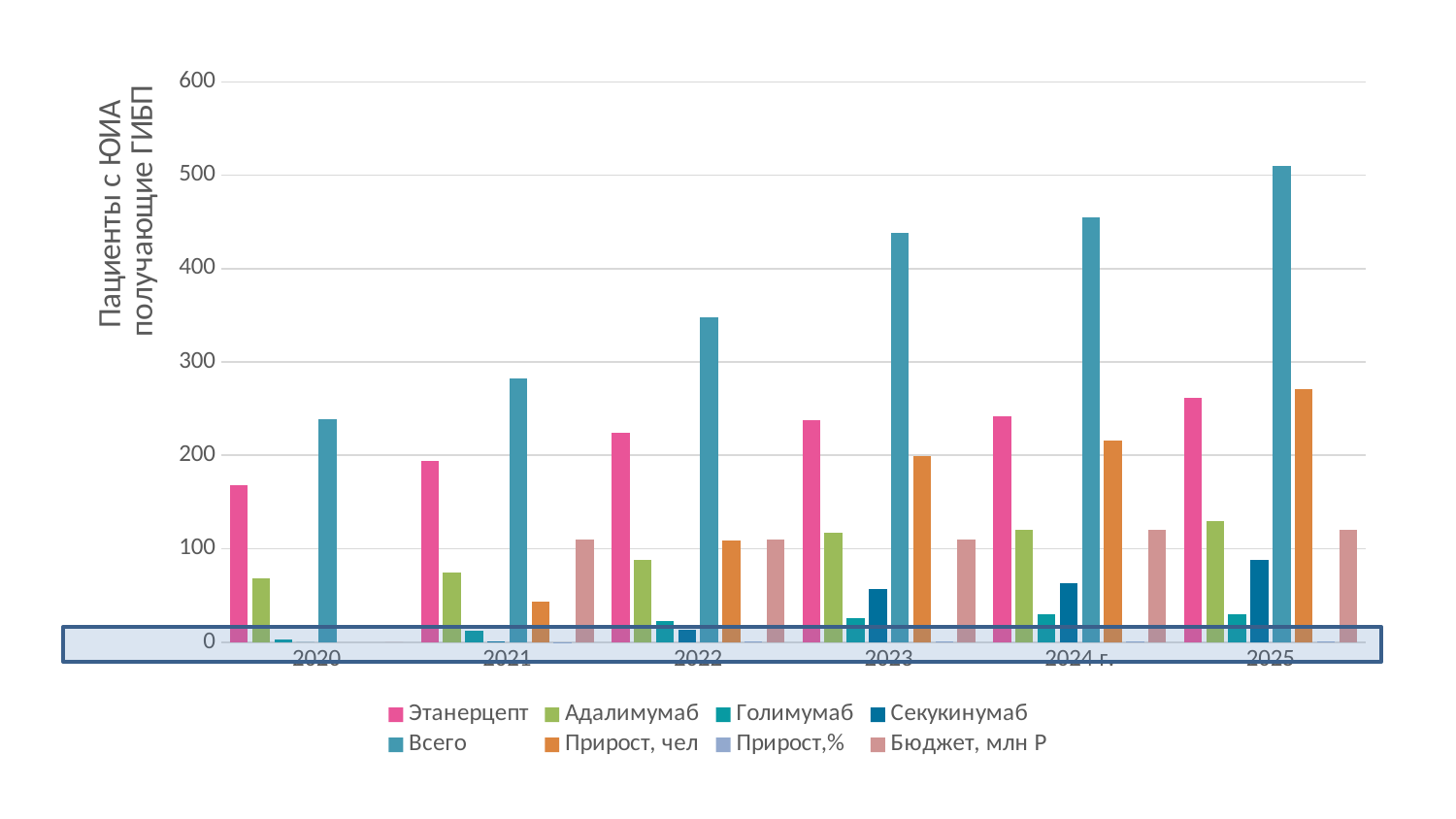
What kind of chart is shown on the slide? bar chart In which year is the value for Всего the highest? 2025 Is the value for Всего in 2020 greater or less than 300? less Is the value for Этанерцепт in 2020 greater or less than 200? less Is the value for Прирост, чел in 2025 greater or less than 200? greater Do the values for Всего rise or fall from 2020 to 2025? rise Which year has the larger value for Прирост, чел: 2022 or 2023? 2023 Which is larger in 2023: the value for Всего or the value for Этанерцепт? Всего In which year is the value for Всего the lowest? 2020 How many series does the legend list? 8 How many year categories are shown on the x axis? 6